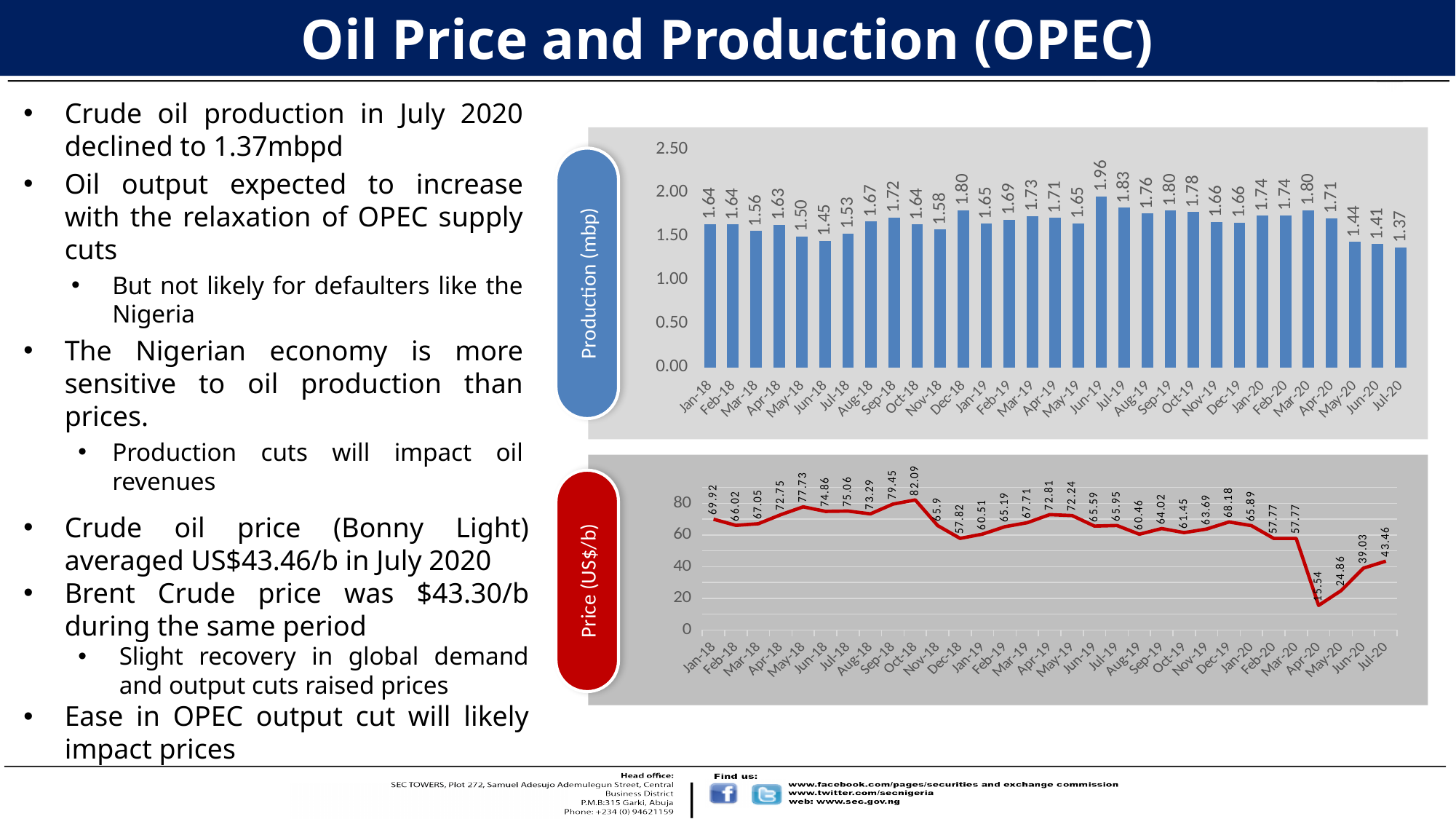
In the Production (mbp) chart, which month has the highest production? Jun-19 In the Price (US$/b) chart, which is larger, the price in Jan-18 or the price in Jul-20? Jan-18 In the Price (US$/b) chart, which month has the lowest price? Apr-20 In the Production (mbp) chart, what is the difference between the production in Jun-19 and Jul-20? 0.59 In the Production (mbp) chart, what is the production value for Jul-20? 1.37 What type of chart is the Production (mbp) chart? bar chart In the Production (mbp) chart, is the production for Jun-18 greater or less than 1.50? less In the Price (US$/b) chart, what is the difference between the price in Jul-20 and the price in Jun-20? 4.43 In the Price (US$/b) chart, what is the price for Oct-18? 82.09 In the Price (US$/b) chart, which month has the highest price? Oct-18 In the Production (mbp) chart, which month has the lowest production? Jul-20 What type of chart is the Price (US$/b) chart? line chart